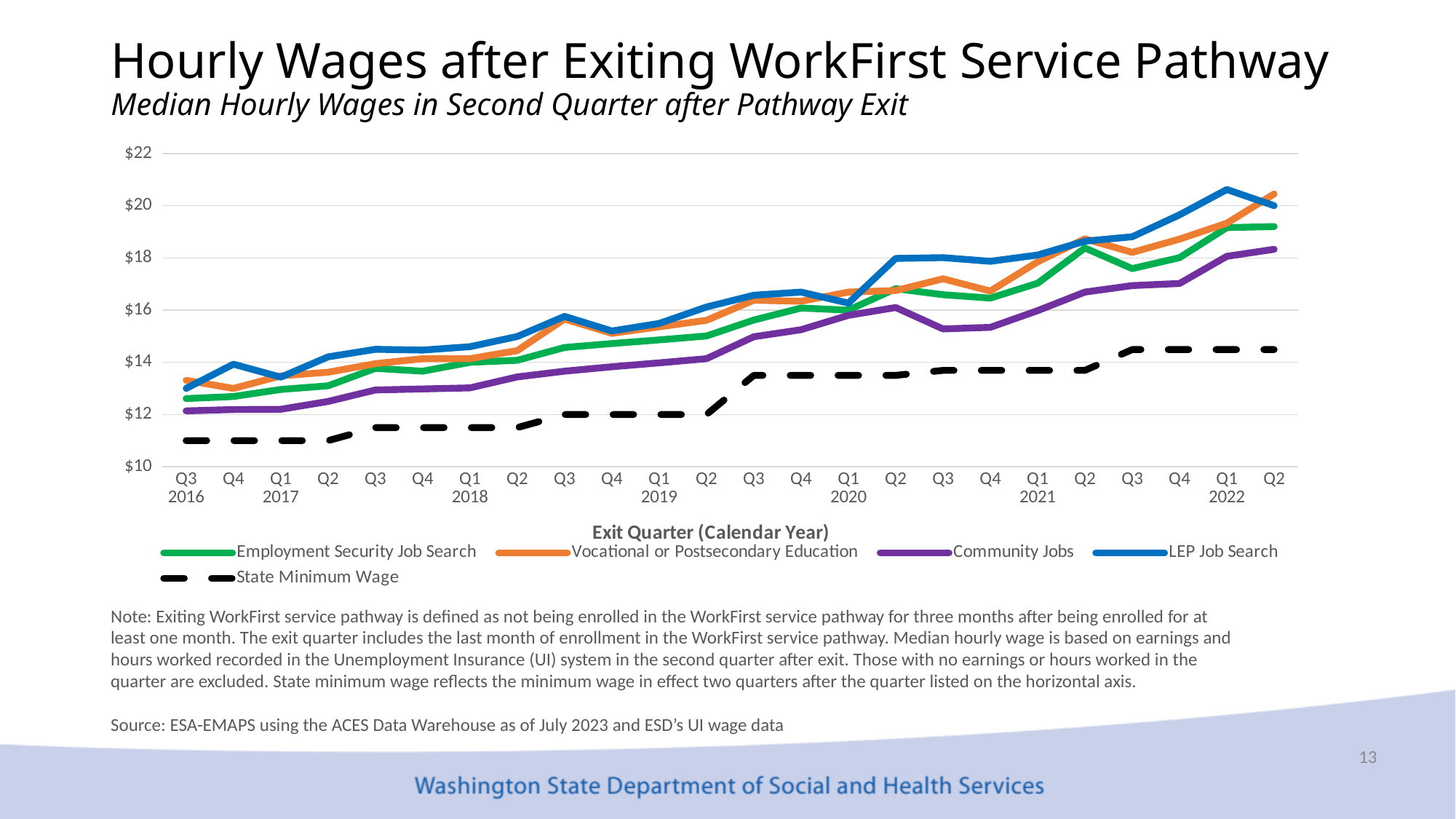
Which series is the highest at Q1 2022? LEP Job Search What is the title of the x axis? Exit Quarter (Calendar Year) Is the value for LEP Job Search at Q1 2022 greater or less than $20? greater How many series does the legend list? 5 Is the value for Community Jobs at Q2 2022 greater or less than $16? greater What kind of chart is shown on the slide? Line chart At Q2 2022, which is higher: Vocational or Postsecondary Education or Community Jobs? Vocational or Postsecondary Education How many exit quarters are plotted along the x axis? 24 Do the Community Jobs median hourly wages generally rise or fall from Q3 2016 to Q2 2022? Rise Which series is the lowest at Q2 2022? State Minimum Wage Which series is drawn as a dashed black line? State Minimum Wage Is the value for State Minimum Wage at Q3 2016 greater or less than $12? less